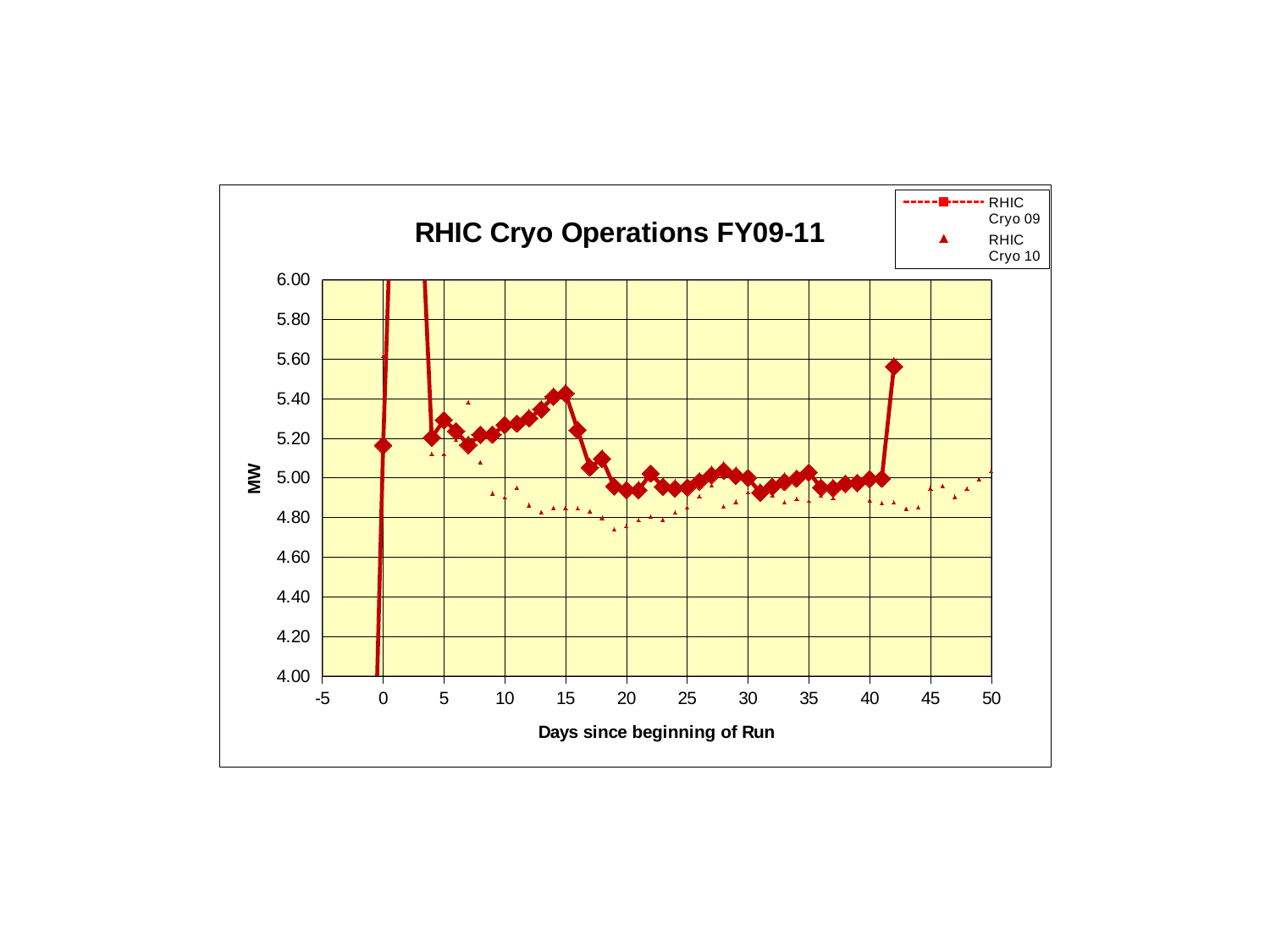
Is the value for RHIC Cryo 10 at day 45 greater or less than 5.00? less What is the label of the x axis? Days since beginning of Run Is the value for RHIC Cryo 10 at day 10 greater or less than 5.00? less What is the title of the chart? RHIC Cryo Operations FY09-11 What kind of chart is shown on the slide? line chart How many series does the legend list? 2